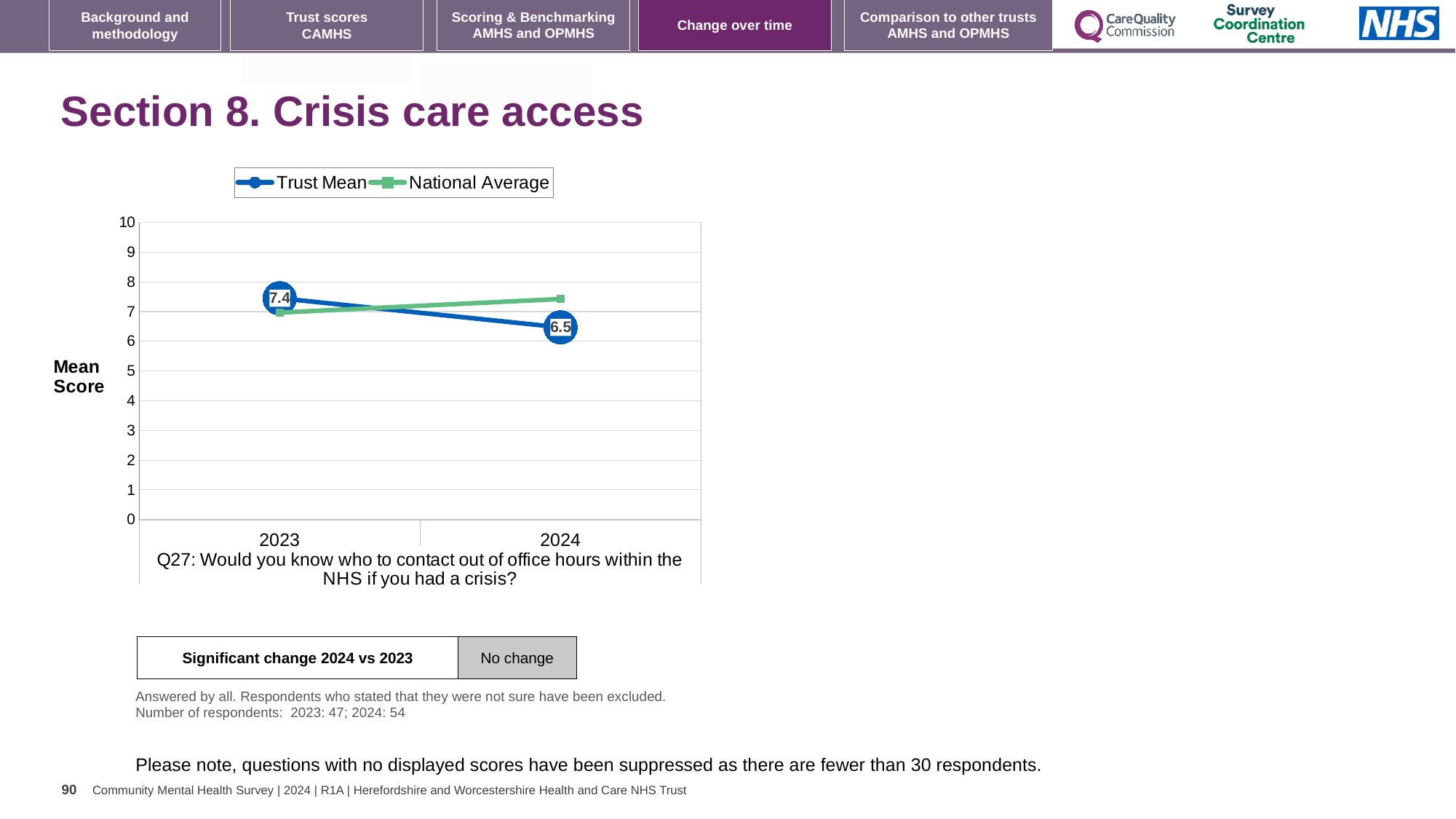
What kind of chart is shown on the slide? line chart What is the Trust Mean score for 2024? 6.5 In which year is the Trust Mean score lowest? 2024 Does the National Average rise or fall from 2023 to 2024? rise In which year is the Trust Mean score highest? 2023 What is the Trust Mean score for 2023? 7.4 How many series does the legend list? 2 Is the National Average value for 2024 greater or less than 7? greater Which is larger in 2023, the Trust Mean or the National Average? Trust Mean Which is larger in 2024, the Trust Mean or the National Average? National Average Does the Trust Mean rise or fall from 2023 to 2024? fall What is the difference between the Trust Mean score in 2023 and in 2024? 0.9